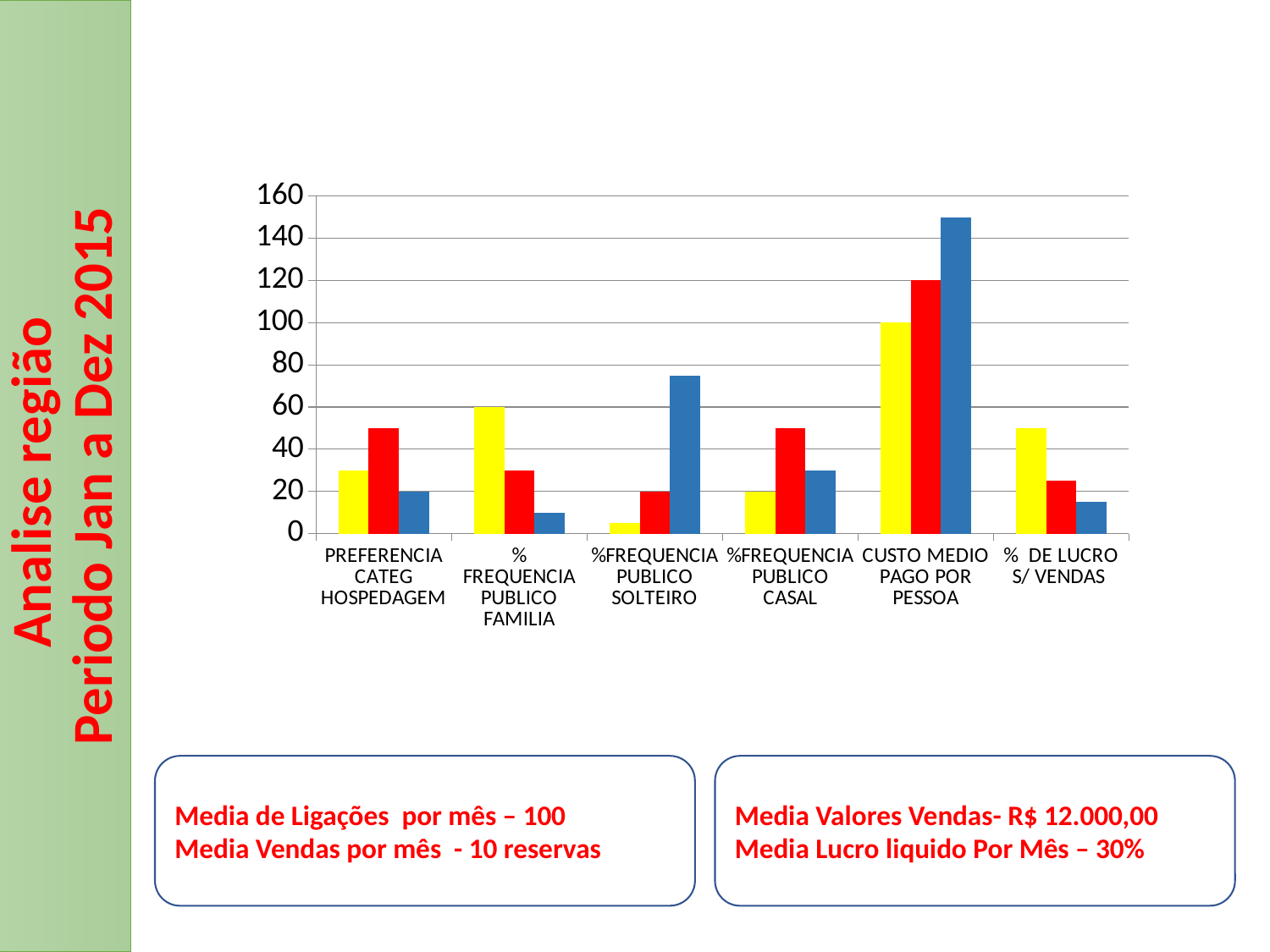
What is the difference between the red bar and the yellow bar for CUSTO MEDIO PAGO POR PESSOA? 20 Is the value of the blue bar for %FREQUENCIA PUBLICO SOLTEIRO greater or less than 60? greater What is the value of the yellow bar for CUSTO MEDIO PAGO POR PESSOA? 100 Which category has the tallest bar in the chart? CUSTO MEDIO PAGO POR PESSOA What is the value of the red bar for CUSTO MEDIO PAGO POR PESSOA? 120 What is the value of the blue bar for PREFERENCIA CATEG HOSPEDAGEM? 20 Is the value of the blue bar for CUSTO MEDIO PAGO POR PESSOA greater or less than 140? greater How many categories are shown on the x axis of the chart? 6 What is the value of the yellow bar for % FREQUENCIA PUBLICO FAMILIA? 60 Which is larger for %FREQUENCIA PUBLICO CASAL: the red bar or the blue bar? the red bar Is the value of the yellow bar for %FREQUENCIA PUBLICO SOLTEIRO greater or less than 20? less What kind of chart is shown on the slide? bar chart